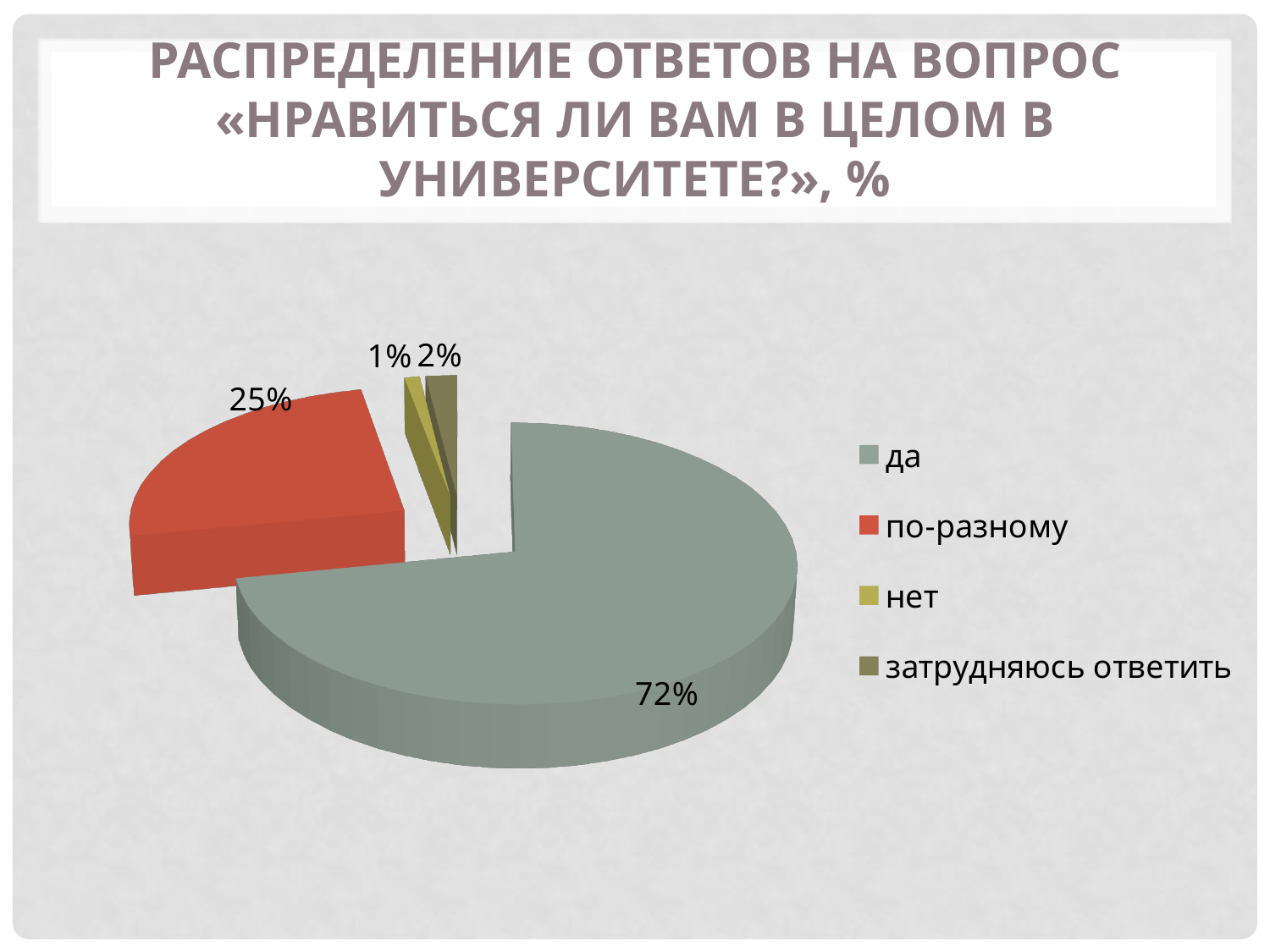
What is the difference in percentage points between «да» and «по-разному»? 47 How many entries does the legend list? 4 Which answer has the smallest share of the pie? нет How many slices does the pie chart have? 4 Which is larger: the share for «по-разному» or the share for «затрудняюсь ответить»? по-разному What percentage of respondents answered «да»? 72% What percentage of respondents answered «по-разному»? 25% Which answer has the largest share of the pie? да What percentage of respondents answered «затрудняюсь ответить»? 2% What percentage of respondents answered «нет»? 1% What kind of chart is shown on the slide? pie chart What colour is the slice for «по-разному»? red